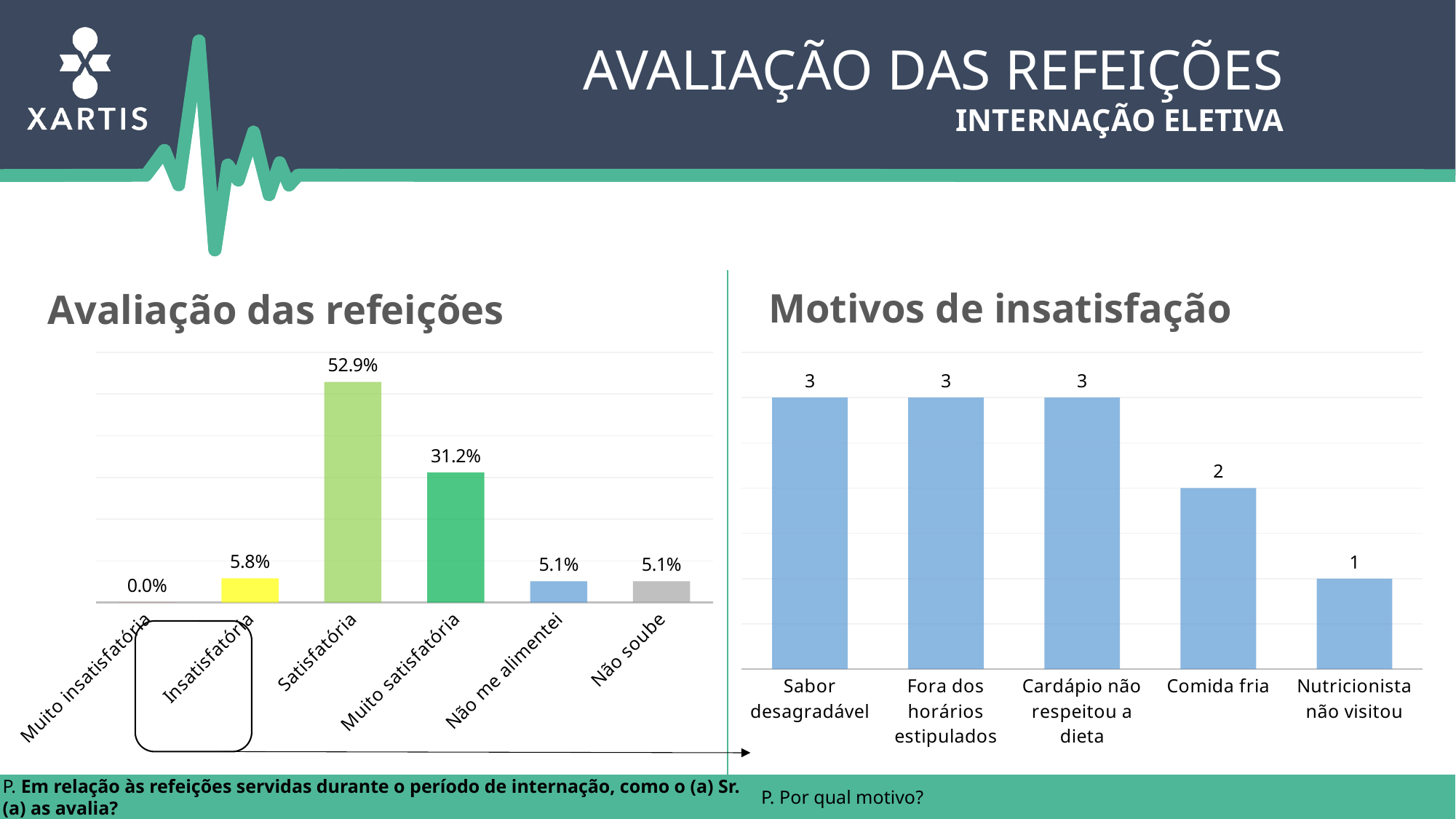
In the 'Avaliação das refeições' chart, which category has the lowest value? Muito insatisfatória In the 'Motivos de insatisfação' chart, which is larger: Sabor desagradável or Comida fria? Sabor desagradável In the 'Avaliação das refeições' chart, what is the value for Muito satisfatória? 31.2% In the 'Motivos de insatisfação' chart, what is the value for Comida fria? 2 In the 'Avaliação das refeições' chart, what is the value for Satisfatória? 52.9% In the 'Avaliação das refeições' chart, how many categories are shown? 6 In the 'Motivos de insatisfação' chart, how many categories are shown? 5 In the 'Avaliação das refeições' chart, what is the value for Insatisfatória? 5.8% What kind of chart is the 'Motivos de insatisfação' chart? Bar chart In the 'Avaliação das refeições' chart, what is the difference between Satisfatória and Muito satisfatória? 21.7% In the 'Motivos de insatisfação' chart, which category has the lowest value? Nutricionista não visitou In the 'Avaliação das refeições' chart, which category has the highest value? Satisfatória